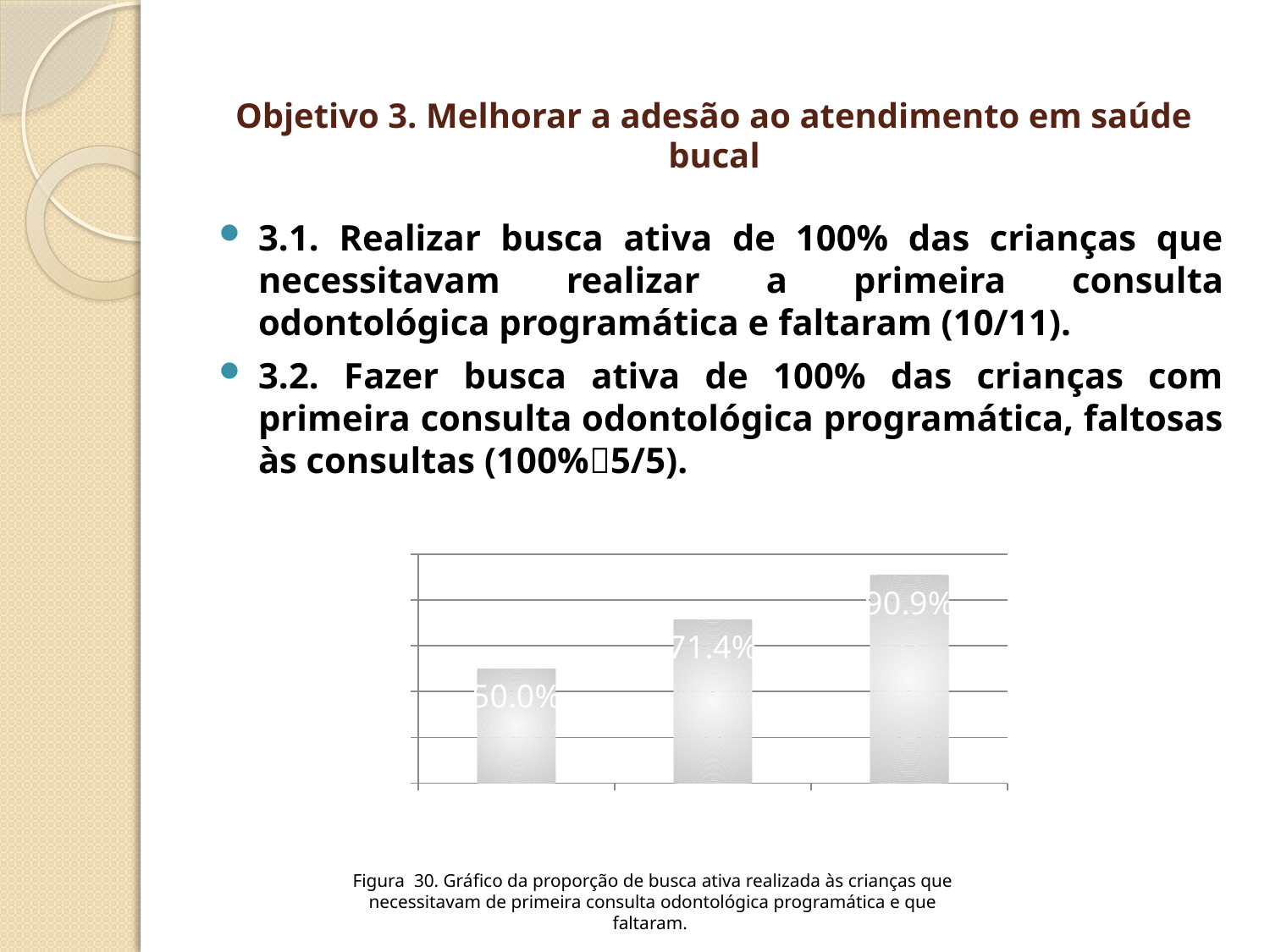
How many bars are plotted in the chart? 3 What kind of chart is shown on the slide? Bar chart What is the value shown on the third (rightmost) bar of the chart? 90.9% What is the value shown on the middle bar of the chart? 71.4% Which bar has the highest value in the chart? The third (rightmost) bar, 90.9% What figure number is given in the caption below the chart? Figura 30 What is the difference between the middle bar and the leftmost bar? 21.4% Which is larger, the middle bar or the rightmost bar? The rightmost bar (90.9%) Do the values rise or fall from left to right across the chart? Rise What is the value shown on the first (leftmost) bar of the chart? 50.0% What is the difference between the rightmost bar and the leftmost bar? 40.9% Which bar has the lowest value in the chart? The first (leftmost) bar, 50.0%